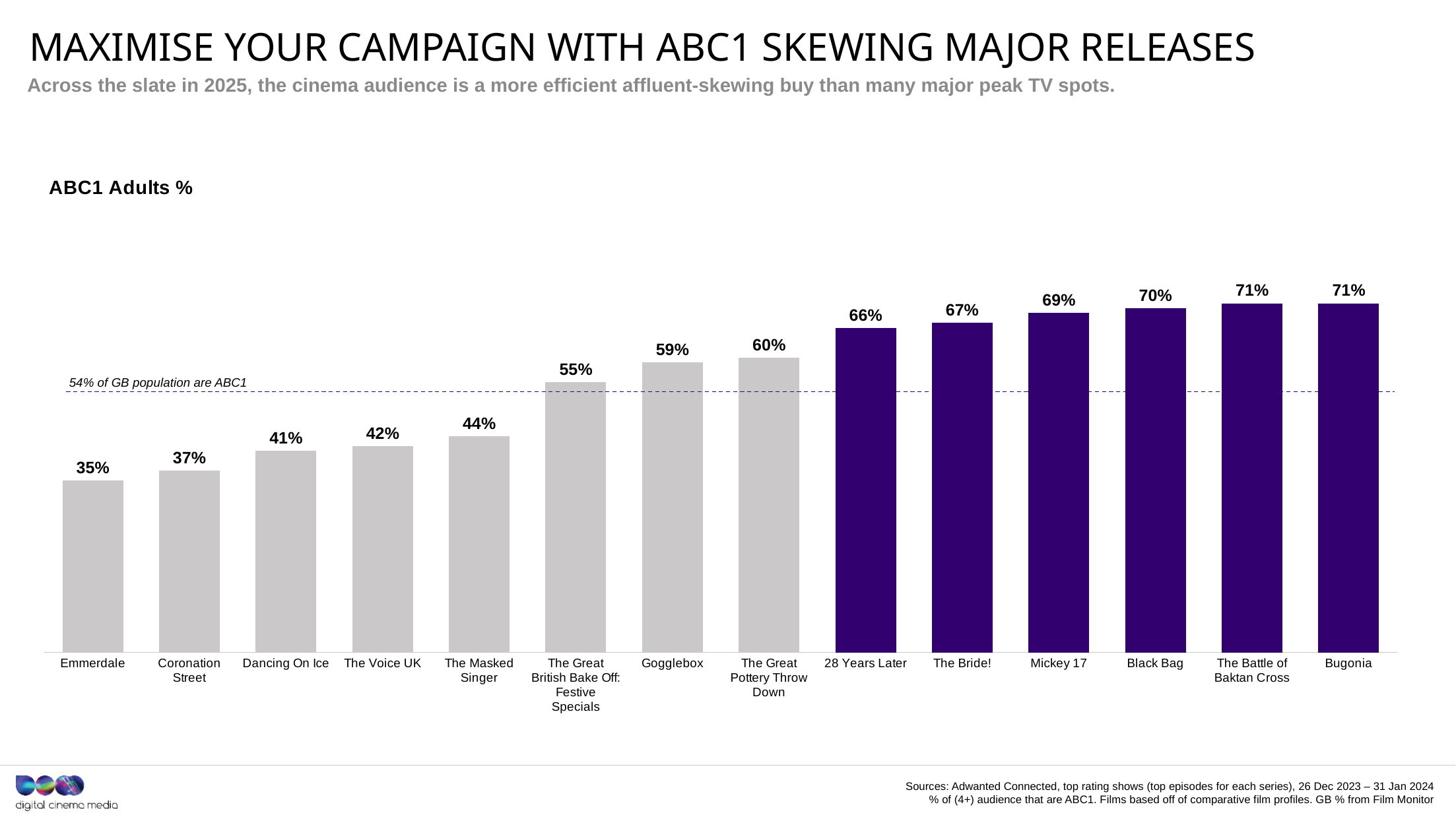
What is the difference between the ABC1 Adults % values for Black Bag and Coronation Street? 33% How many categories are shown on the chart? 14 What percentage of the GB population are ABC1, according to the dashed reference line? 54% Which category has the lowest ABC1 Adults % value? Emmerdale Which has a higher ABC1 Adults % value, The Bride! or The Great Pottery Throw Down? The Bride! What is the ABC1 Adults % value for Mickey 17? 69% What is the ABC1 Adults % value for Gogglebox? 59% Do the values rise or fall from left to right along the x axis? Rise What is the highest ABC1 Adults % value shown on the chart? 71% What is the difference between the ABC1 Adults % values for 28 Years Later and The Great British Bake Off: Festive Specials? 11% What is the ABC1 Adults % value for The Masked Singer? 44% What kind of chart is shown on the slide? Bar chart